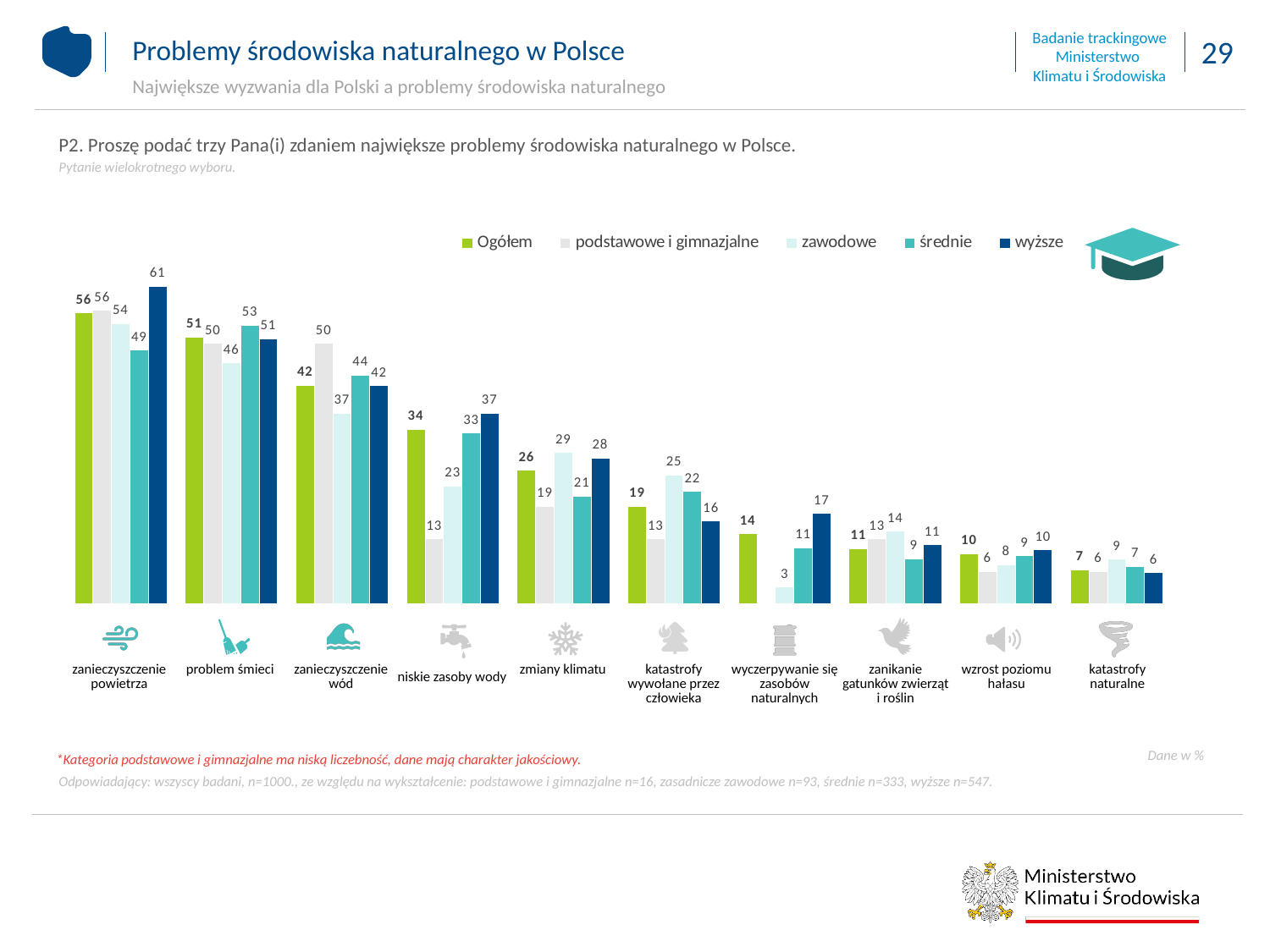
How many series does the legend list? 5 What is the zawodowe value for niskie zasoby wody? 23 What is the średnie value for katastrofy wywołane przez człowieka? 22 How many categories are shown on the x axis? 10 What is the difference between the wyższe and podstawowe i gimnazjalne values for niskie zasoby wody? 24 Which is larger for zmiany klimatu: the zawodowe value or the średnie value? zawodowe What kind of chart is shown on the slide? bar chart Which category has the highest Ogółem value? zanieczyszczenie powietrza Do the Ogółem values rise or fall from left to right along the x axis? fall What is the wyższe value for zanieczyszczenie powietrza? 61 Which category has the lowest Ogółem value? katastrofy naturalne What is the Ogółem value for zanieczyszczenie powietrza? 56